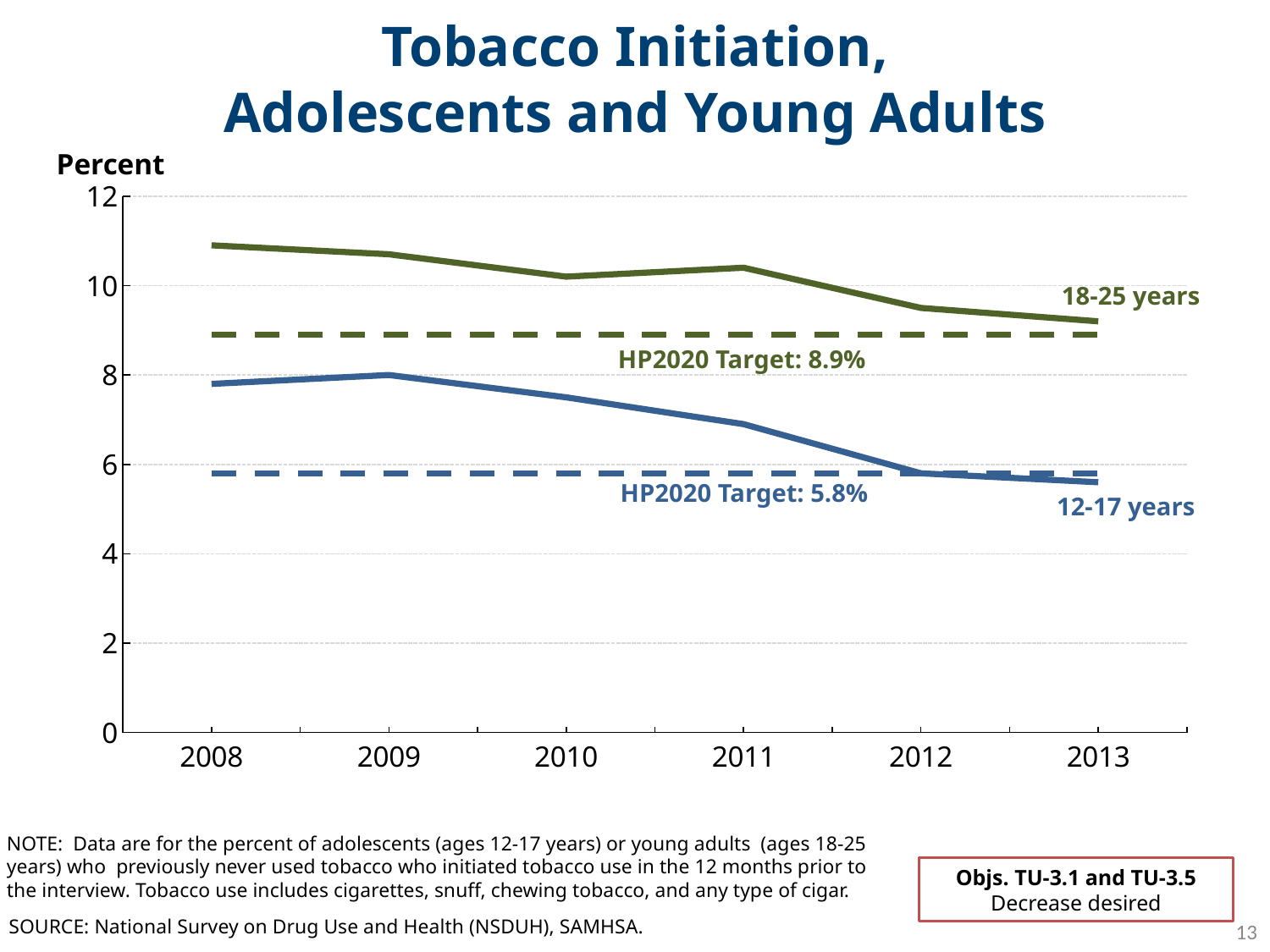
In which year is the 18-25 years group's tobacco initiation rate lowest? 2013 Does the tobacco initiation rate for the 12-17 years group rise or fall from 2009 to 2013? Fall In 2008, which group has the higher tobacco initiation rate, 18-25 years or 12-17 years? 18-25 years What is the HP2020 target for the 12-17 years group? 5.8% Is the value for the 12-17 years group in 2011 greater or less than 8? less What kind of chart is shown on the slide? Line chart What is the label on the y axis of the chart? Percent Is the value for the 18-25 years group in 2013 greater or less than 10? less How many years are plotted along the x axis? 6 What is the HP2020 target for the 18-25 years group? 8.9% Does the tobacco initiation rate for the 18-25 years group rise or fall from 2008 to 2013 overall? Fall Is the value for the 18-25 years group in 2008 greater or less than 10? greater